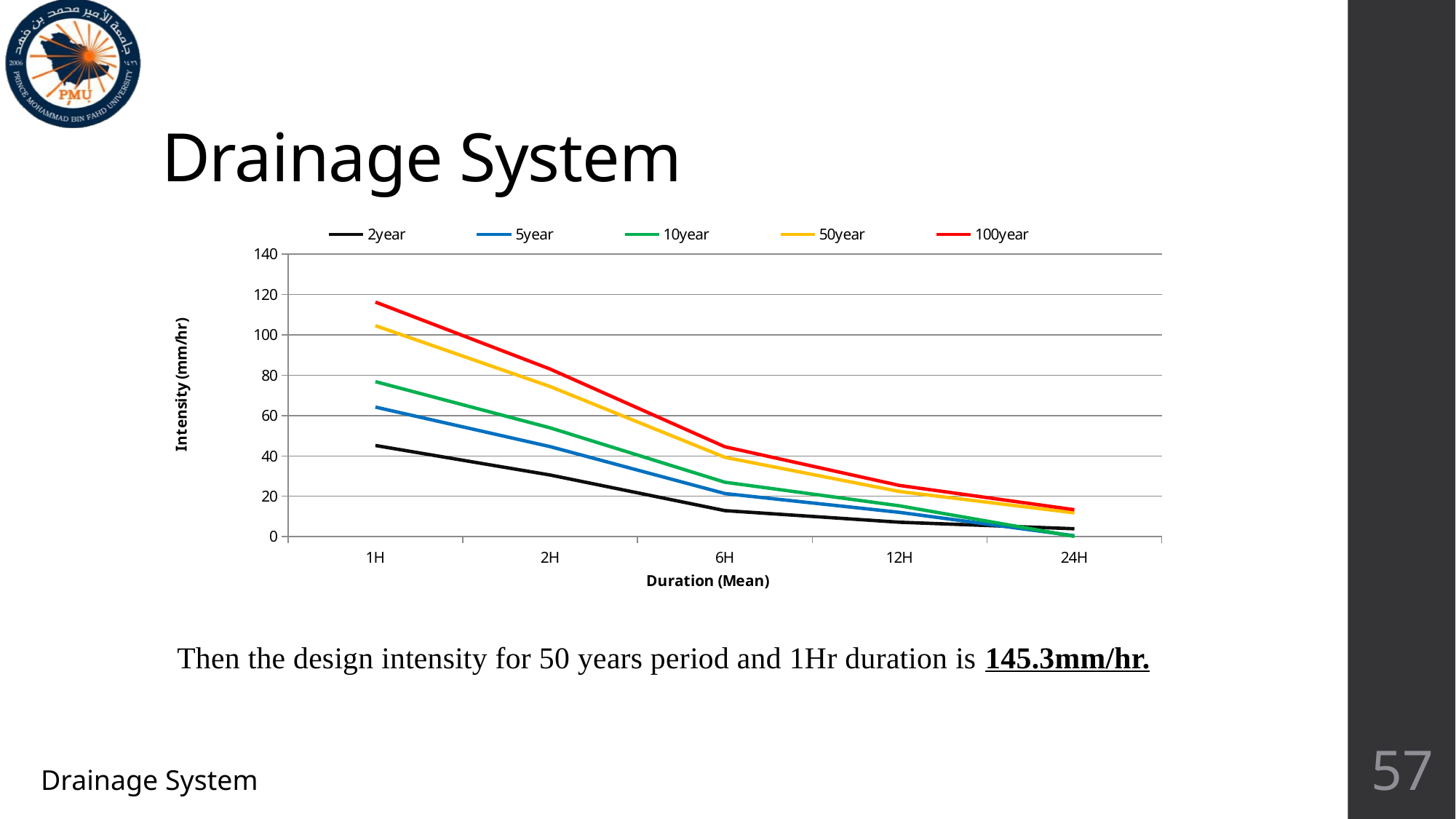
How many duration categories are shown on the x axis? 5 Is the value for the 2year series at 1H greater or less than 60? less Which series has the highest intensity at 1H? 100year Is the value for the 10year series at 1H greater or less than 60? greater How many series does the legend list? 5 Is the value for the 50year series at 6H greater or less than 60? less At 1H, which series has the larger value, 100year or 2year? 100year Which series has the lowest intensity at 1H? 2year What kind of chart is shown on the slide? line chart What is the title of the vertical axis? Intensity (mm/hr) Does the 100year series rise or fall as duration increases from 1H to 24H? fall